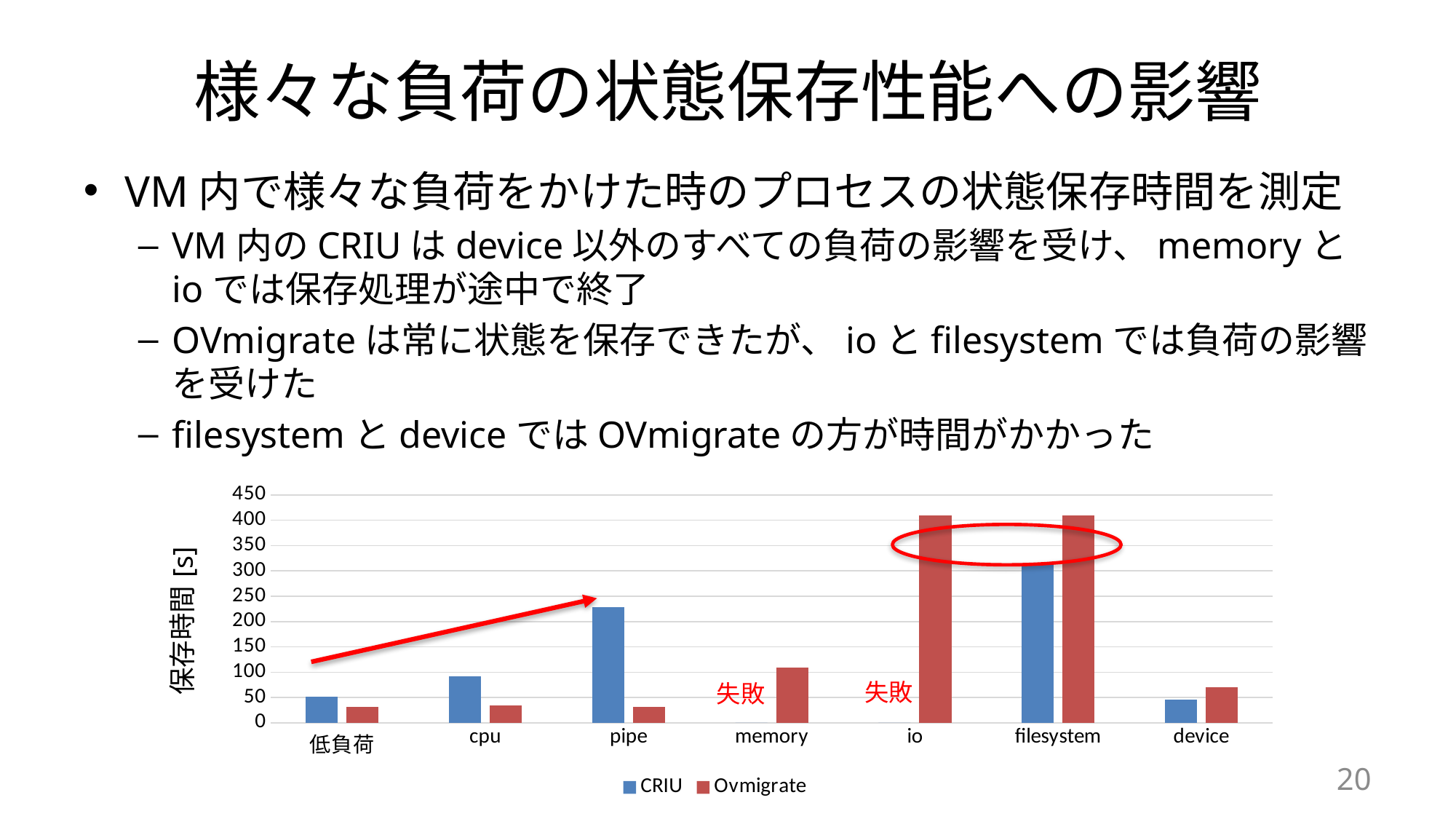
For the filesystem category, which series has the larger value, CRIU or Ovmigrate? Ovmigrate What kind of chart is shown on the slide? bar chart For the device category, which series has the larger value, CRIU or Ovmigrate? Ovmigrate What is the label of the vertical axis of the chart? 保存時間 [s] For the pipe category, which series has the larger value, CRIU or Ovmigrate? CRIU How many series does the chart legend list? 2 How many load categories are shown on the x axis of the chart? 7 Is the Ovmigrate value for io greater or less than 350? greater Which category has the highest CRIU value? filesystem Is the CRIU value for pipe greater or less than 200? greater Which categories are marked with the red label 失敗 (failure) in the chart? memory and io Is the Ovmigrate value for device greater or less than 100? less